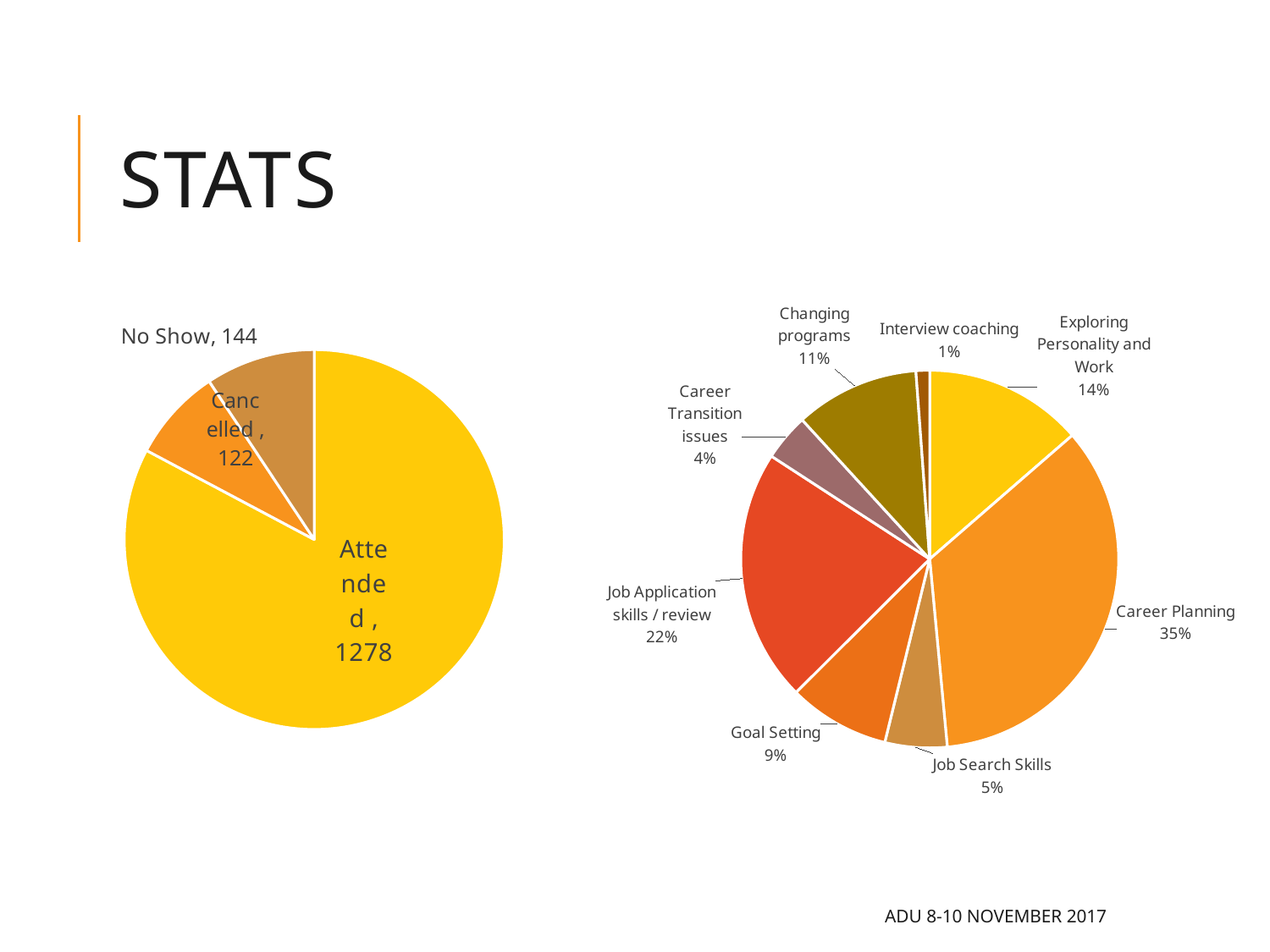
In the pie chart on the left, what is the value for No Show? 144 In the pie chart on the left, what is the difference between No Show and Cancelled? 22 In the pie chart on the left, which category has the smallest value? Cancelled In the pie chart on the left, what is the value for Attended? 1278 In the pie chart on the right, how many categories are shown? 8 In the pie chart on the left, what is the total of Attended, Cancelled and No Show? 1544 In the pie chart on the right, what percentage is Career Planning? 35% In the pie chart on the right, what percentage is Job Application skills / review? 22% In the pie chart on the right, which category has the smallest share? Interview coaching What type of chart is shown on the left of the slide? Pie chart In the pie chart on the right, which is larger: Goal Setting or Job Search Skills? Goal Setting In the pie chart on the right, which category has the largest share? Career Planning